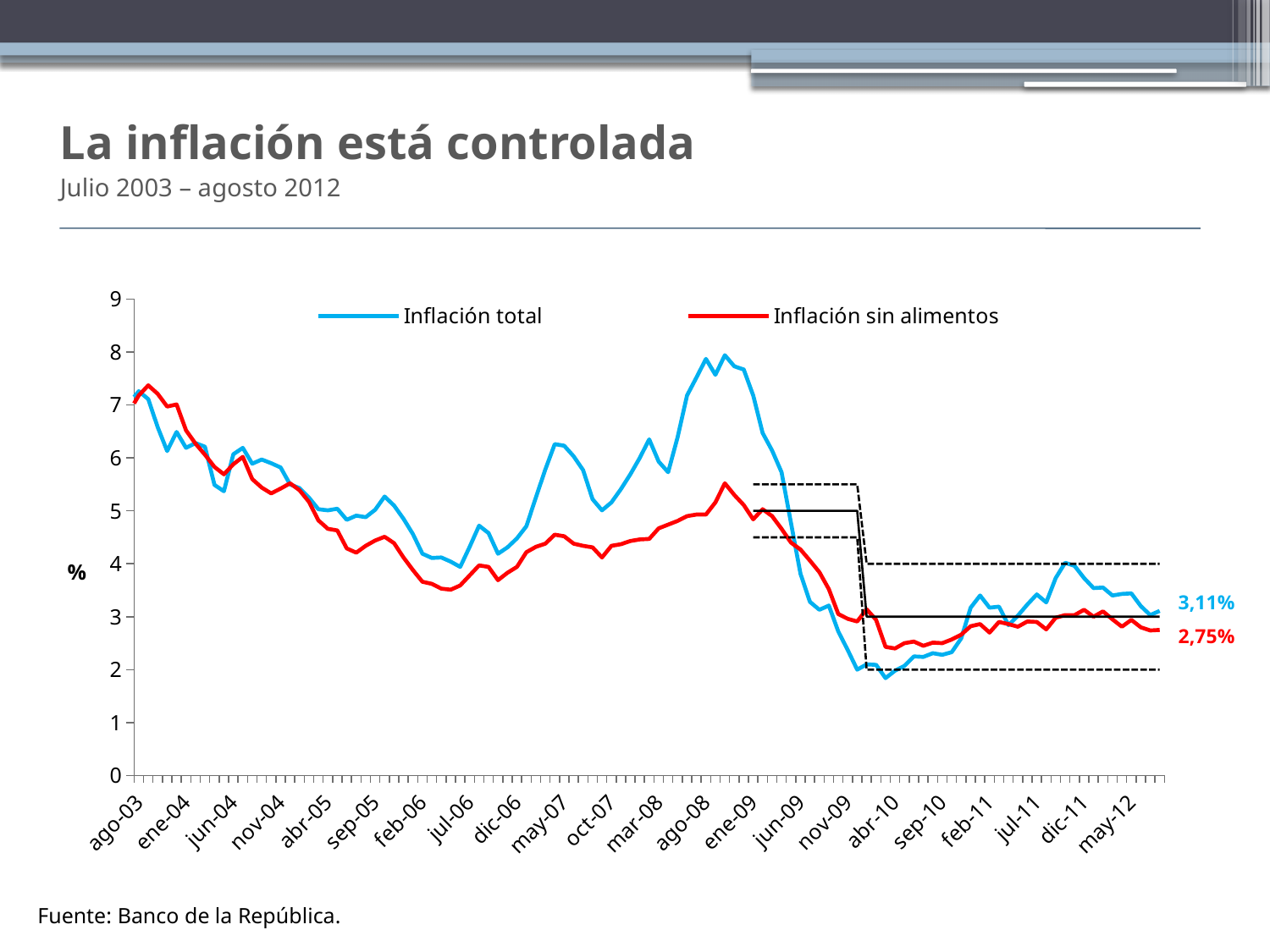
At the end of the series, which is higher: Inflación total or Inflación sin alimentos? Inflación total What is the final labelled value of Inflación sin alimentos? 2,75% Is the value for Inflación sin alimentos at feb-06 greater or less than 4? less What is the title of the slide containing the chart? La inflación está controlada Which series reaches the highest peak over the whole period? Inflación total Is the value for Inflación total at abr-10 greater or less than 3? less What is the difference between the final labelled values of Inflación total (3,11%) and Inflación sin alimentos (2,75%)? 0,36% Is the value for Inflación total at ago-08 greater or less than 7? greater What kind of chart is shown on the slide? line chart Overall, from ago-03 to may-12, does Inflación total rise or fall? fall What is the final labelled value of Inflación total? 3,11% How many series does the legend list? 2